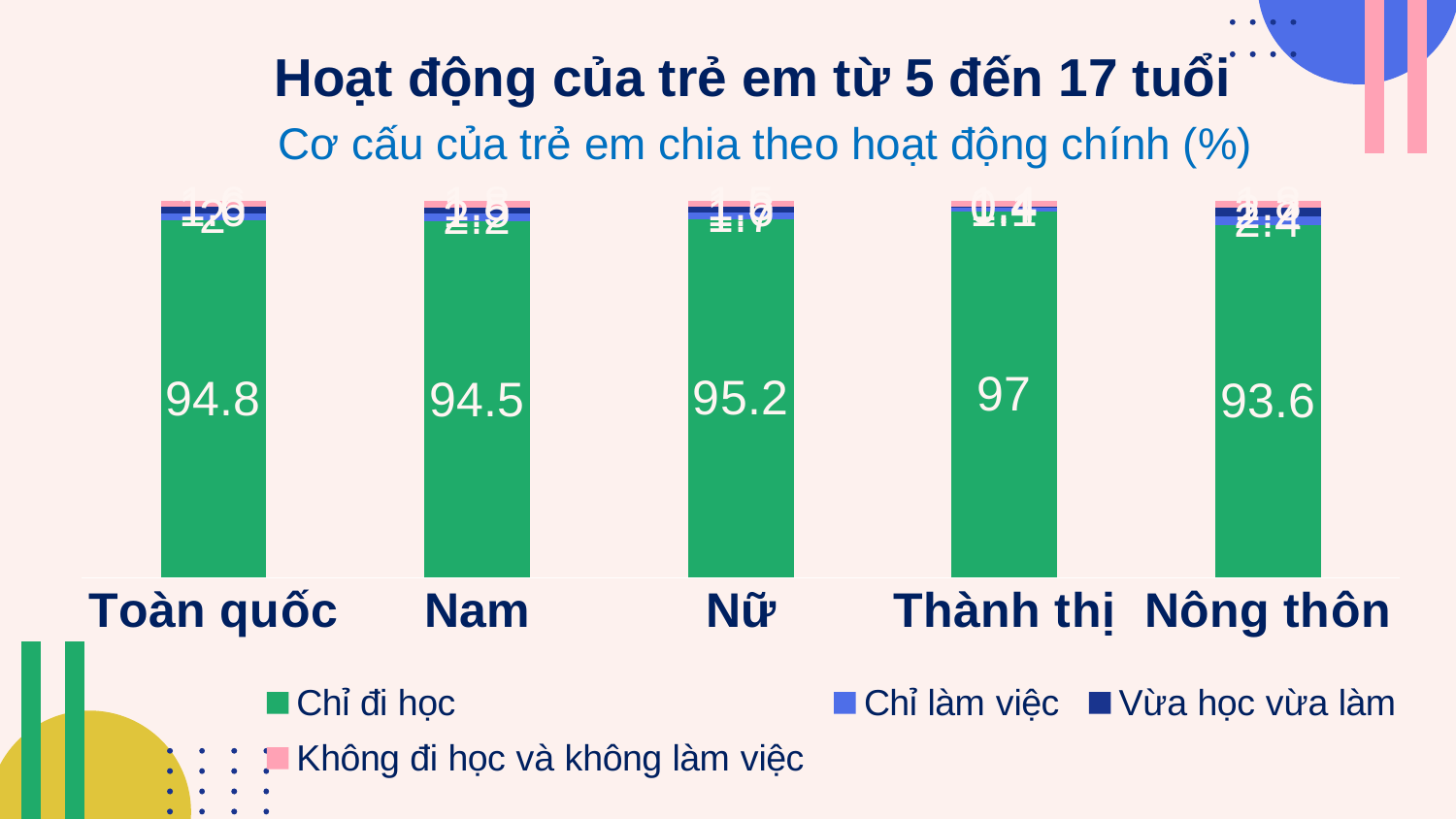
What is the value of "Chỉ đi học" for Nữ? 95.2 How many categories are shown on the x axis? 5 What is the value of "Chỉ đi học" for Nông thôn? 93.6 What is the difference between the "Chỉ đi học" values for Thành thị and Nông thôn? 3.4 How many series does the legend list? 4 Which category has the highest value for "Chỉ đi học"? Thành thị Which category has the lowest value for "Chỉ đi học"? Nông thôn What is the value of "Chỉ đi học" for Thành thị? 97 What is the value of "Chỉ đi học" for Toàn quốc? 94.8 What kind of chart is shown on the slide? Stacked bar chart What is the value of "Chỉ đi học" for Nam? 94.5 Which has a larger "Chỉ đi học" value, Nam or Nữ? Nữ